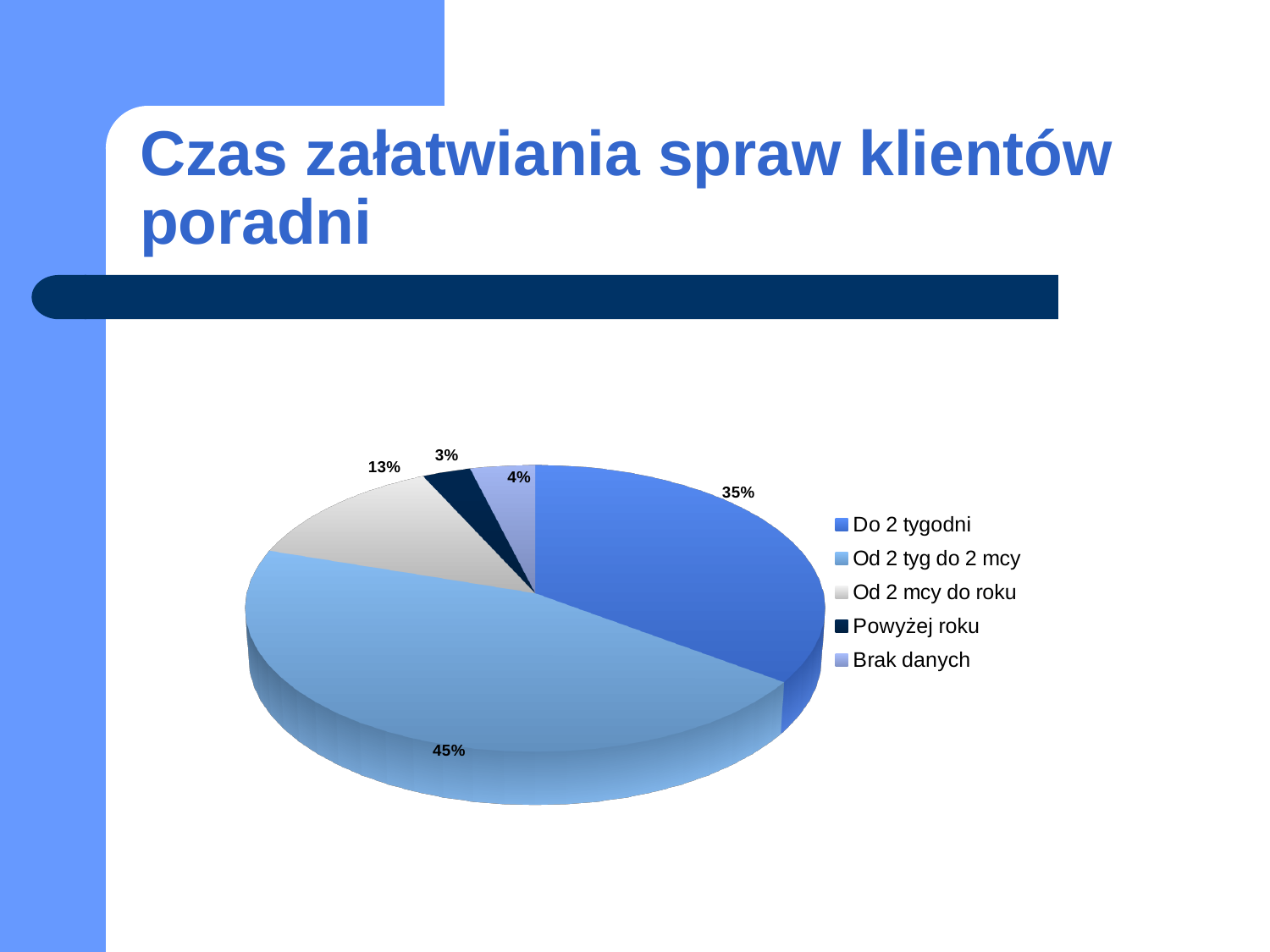
What is the difference in percentage points between "Od 2 tyg do 2 mcy" and "Do 2 tygodni"? 10 percentage points What kind of chart is shown on the slide? Pie chart What share of the pie does "Powyżej roku" have? 3% Which category has the largest slice of the pie? Od 2 tyg do 2 mcy What is the title of the slide containing the pie chart? Czas załatwiania spraw klientów poradni What share of the pie does "Brak danych" have? 4% Which is larger: the share for "Brak danych" or the share for "Powyżej roku"? Brak danych Which category has the smallest slice of the pie? Powyżej roku How many categories does the pie chart have? 5 What share of the pie does "Do 2 tygodni" have? 35%